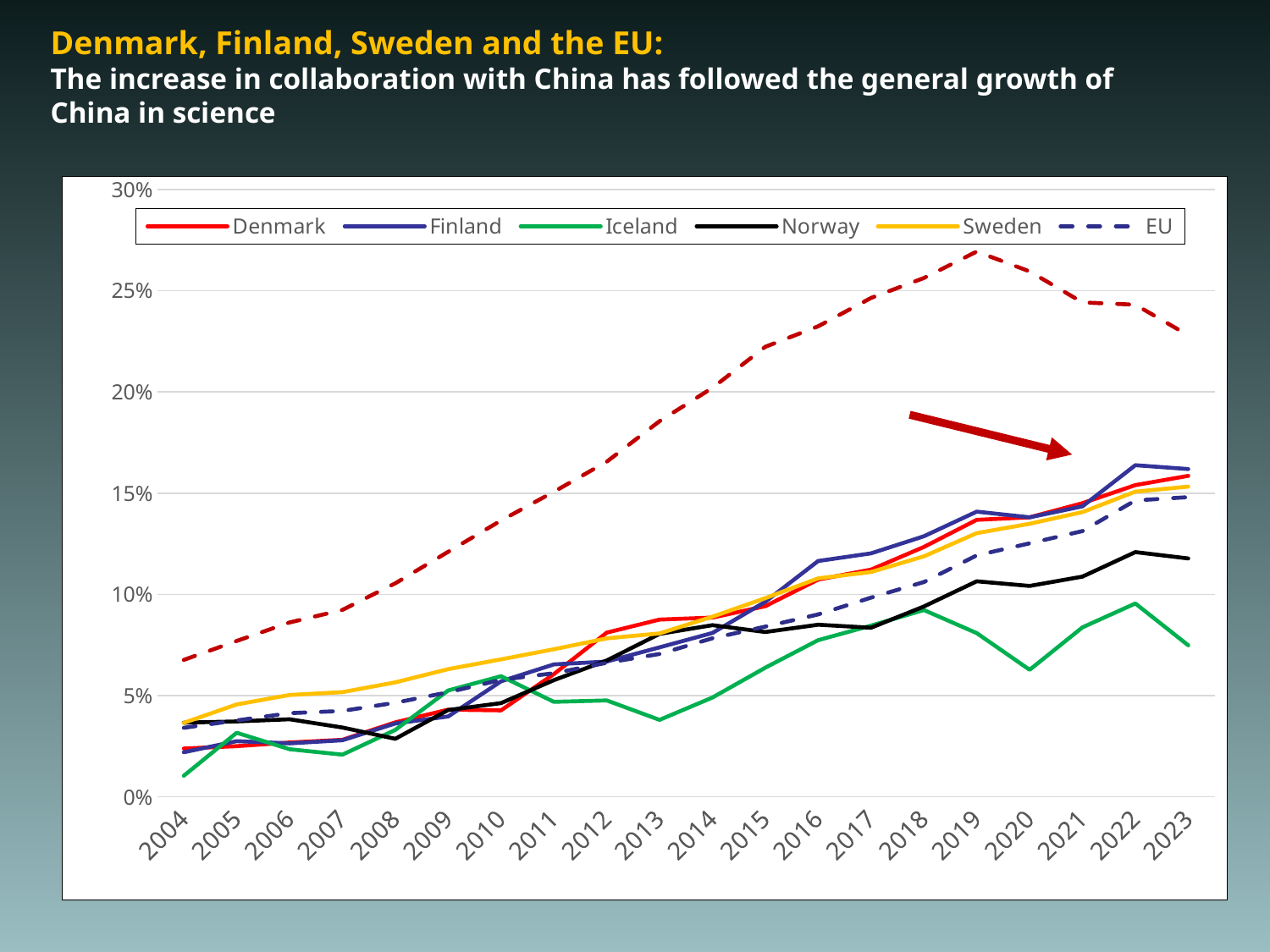
Is the value for Iceland in 2023 greater or less than 10%? less Which of the legend series has the lowest value in 2020? Iceland Is the value for Norway in 2023 greater or less than 15%? less Does the Finland line generally rise or fall from 2004 to 2023? rise In 2023, which is larger, the value for Finland or the value for Iceland? Finland What kind of chart is shown on the slide? line chart Which legend entry is drawn with a dashed line? EU How many series does the legend list? 6 Is the value for Iceland in 2004 greater or less than 5%? less How many years are shown along the x axis? 20